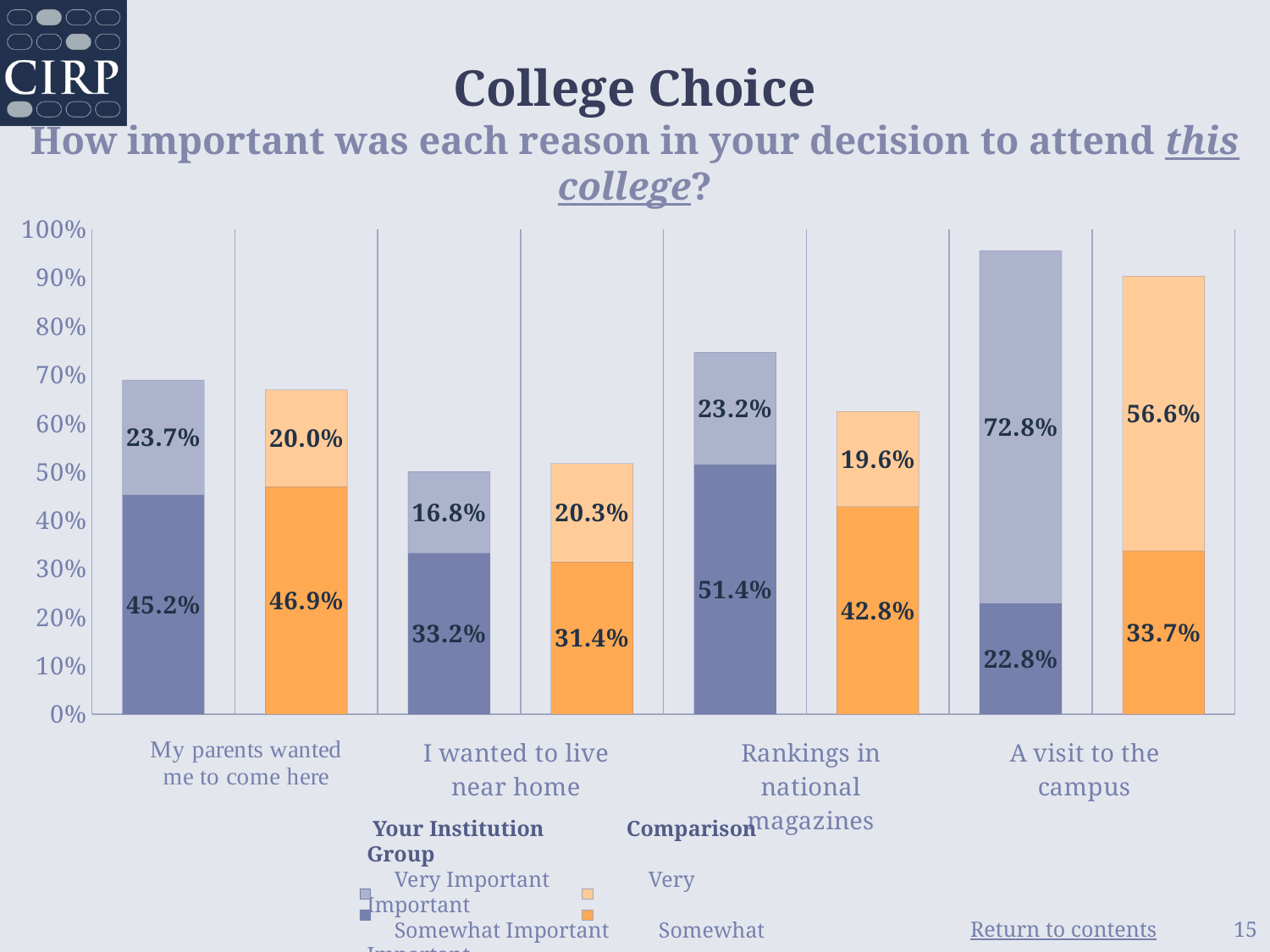
What percentage of the Comparison Group rated "I wanted to live near home" as Very Important? 20.3% How many reasons (categories) are shown on the x axis? 4 Which reason has the lowest Very Important percentage for Your Institution? I wanted to live near home What is the total stacked percentage (Very Important plus Somewhat Important) for "A visit to the campus" for Your Institution? 95.6% What type of chart is shown on the slide? Stacked bar chart What percentage of the Comparison Group rated "My parents wanted me to come here" as Somewhat Important? 46.9% For "Rankings in national magazines", which group has the larger Somewhat Important percentage, Your Institution or the Comparison Group? Your Institution What is the total stacked percentage for "I wanted to live near home" for the Comparison Group? 51.7% What percentage of Your Institution students rated "A visit to the campus" as Very Important? 72.8% What percentage of Your Institution students rated "Rankings in national magazines" as Somewhat Important? 51.4% Which reason has the highest Very Important percentage for Your Institution? A visit to the campus What is the difference between the Very Important percentages for "A visit to the campus" for Your Institution and the Comparison Group? 16.2%